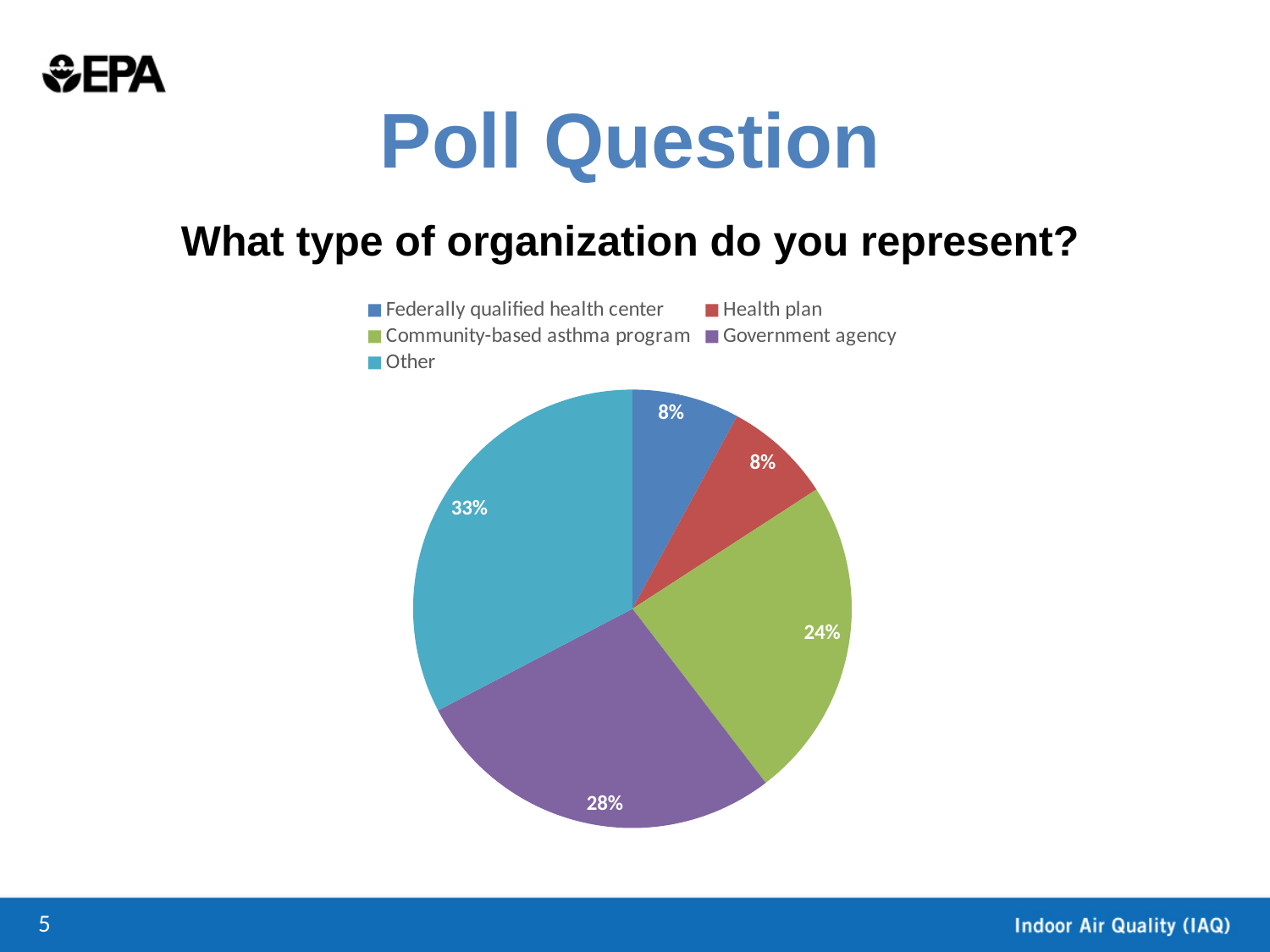
Which organization type has the largest share of the pie? Other What colour is the "Other" slice in the pie chart? teal How many categories does the pie chart show? 5 What share of the pie does "Other" represent? 33% What kind of chart is shown on the slide? pie chart What percentage of respondents represent a federally qualified health center? 8% Which is larger, the share for "Government agency" or the share for "Community-based asthma program"? Government agency What is the difference in percentage points between "Other" and "Government agency"? 5 What percentage of respondents represent a government agency? 28% What is the combined share of "Federally qualified health center" and "Health plan"? 16% What percentage of respondents represent a health plan? 8% What percentage of respondents represent a community-based asthma program? 24%